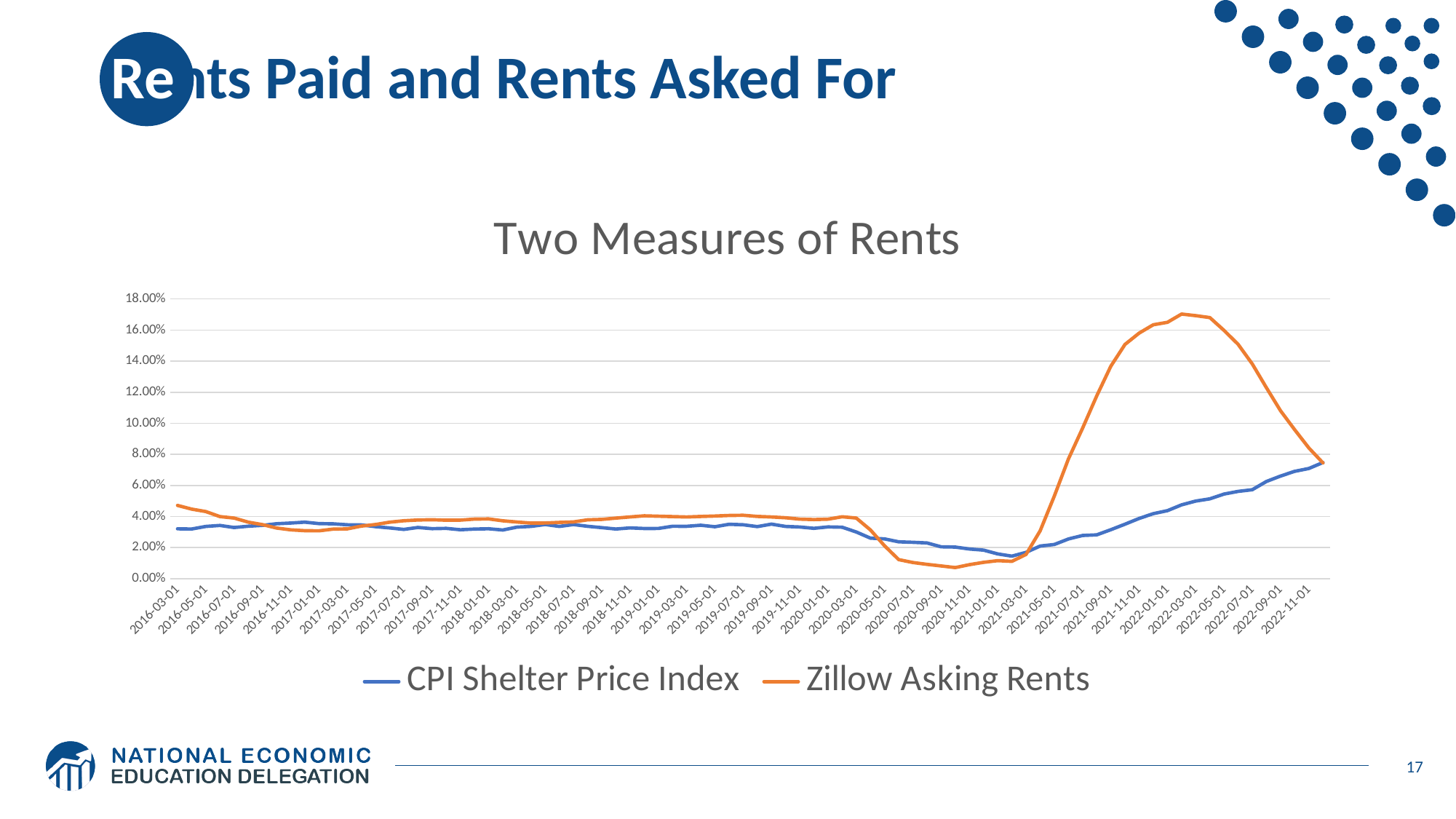
At 2020-11-01, which series has the larger value, CPI Shelter Price Index or Zillow Asking Rents? CPI Shelter Price Index Does the Zillow Asking Rents line rise or fall between 2022-03-01 and 2022-11-01? fall What kind of chart is shown on the slide? line chart At 2022-03-01, which series has the larger value, CPI Shelter Price Index or Zillow Asking Rents? Zillow Asking Rents Which series reaches the highest value on the chart? Zillow Asking Rents Is the value for Zillow Asking Rents at 2022-03-01 greater or less than 16.00%? greater Is the value for CPI Shelter Price Index at 2016-03-01 greater or less than 4.00%? less How many series does the legend list? 2 Which colour is used for the Zillow Asking Rents line? orange Is the value for CPI Shelter Price Index at 2022-11-01 greater or less than 6.00%? greater What is the title of the chart? Two Measures of Rents